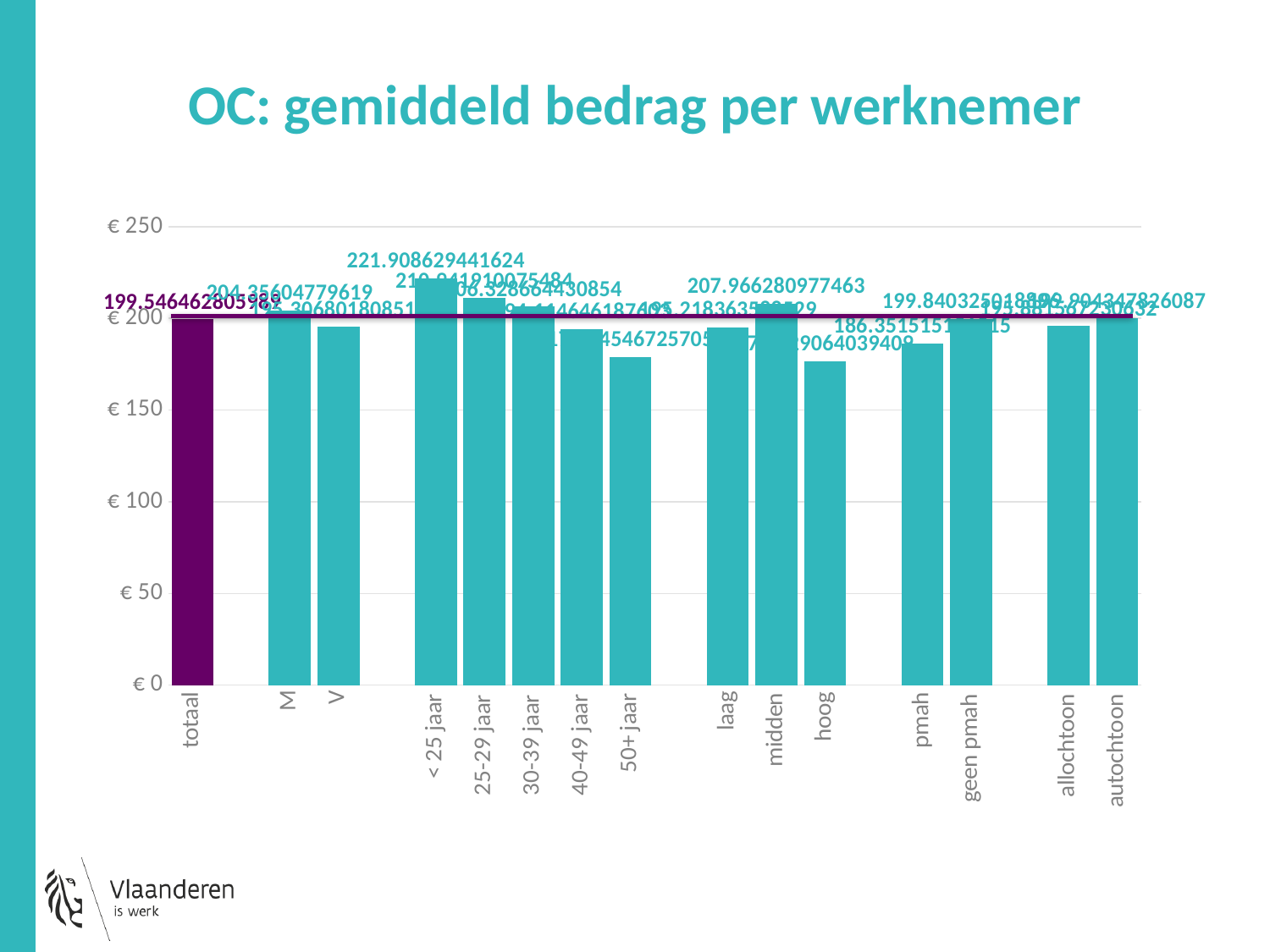
What is the value for '< 25 jaar'? 221.908629441624 Which is larger, the value for 'pmah' or the value for 'geen pmah'? geen pmah Is the value for 'midden' greater or less than 150? greater Is the value for 'hoog' greater or less than 200? less Which category has the highest value? < 25 jaar How many categories (bars) are plotted in the chart? 15 What is the title of the chart? OC: gemiddeld bedrag per werknemer Which is larger, the value for 'laag' or the value for 'hoog'? laag What type of chart is shown on the slide? bar chart Is the value for '50+ jaar' greater or less than 200? less